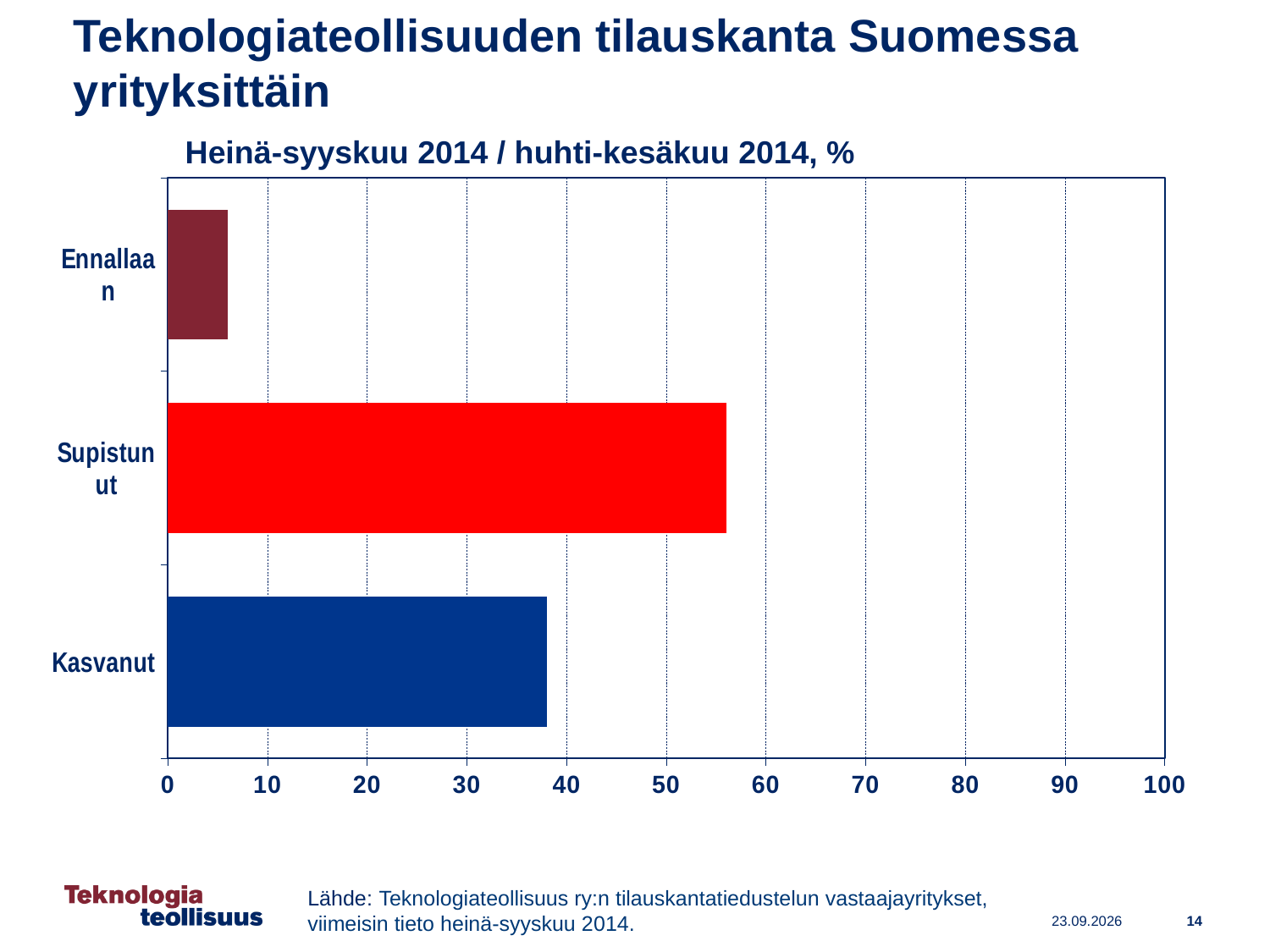
How many categories are shown in the chart? 3 Which category has the lowest value? Ennallaan What kind of chart is shown on the slide? bar chart Is the value for Ennallaan greater or less than 10? less Which is larger, the value for Ennallaan or the value for Kasvanut? Kasvanut Is the value for Supistunut greater or less than 50? greater What colour is the bar for Kasvanut? blue Which is larger, the value for Kasvanut or the value for Supistunut? Supistunut Which category has the highest value? Supistunut Is the value for Kasvanut greater or less than 30? greater What is the title of the chart? Heinä-syyskuu 2014 / huhti-kesäkuu 2014, %